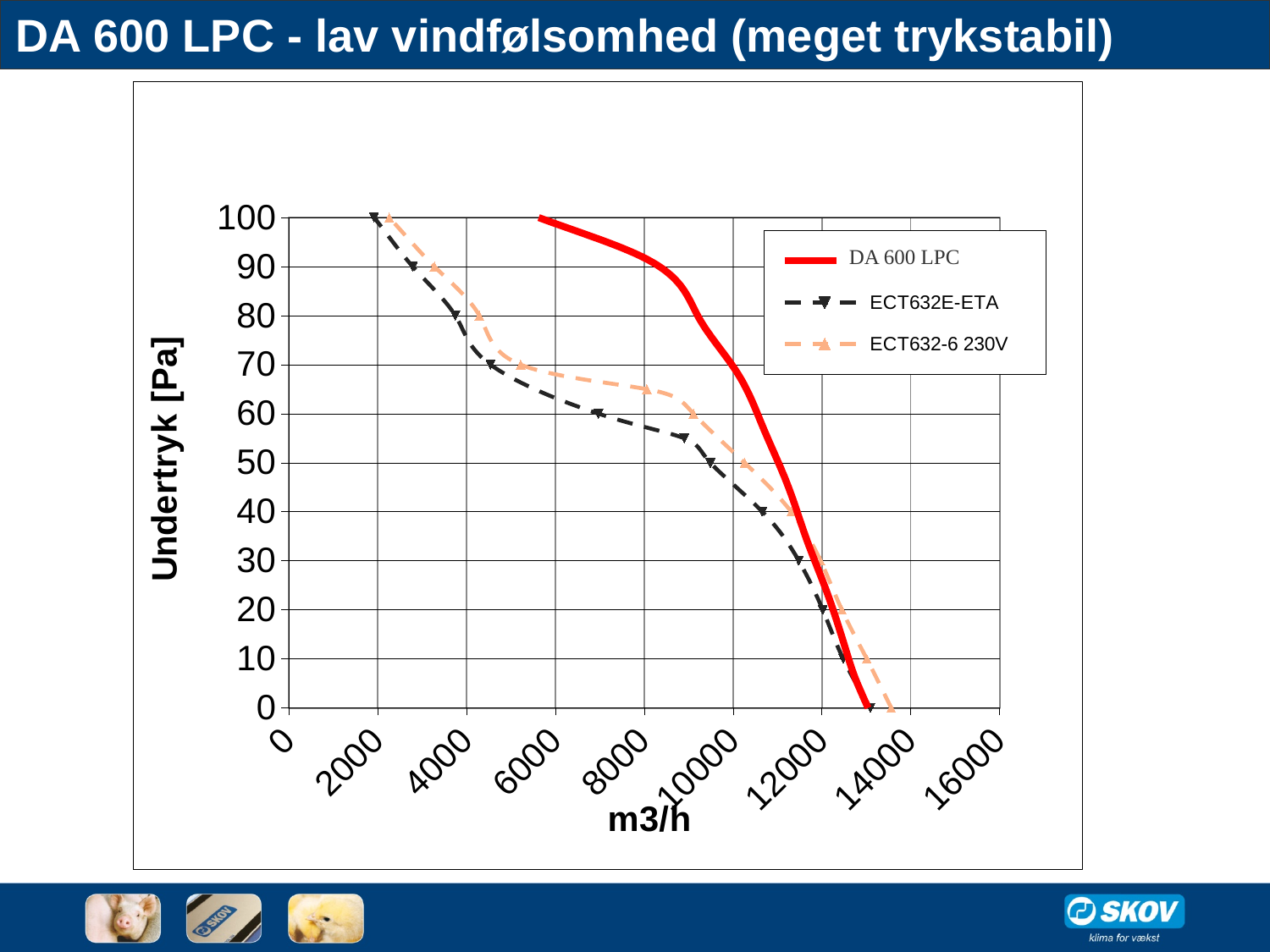
At 80 Pa, which series has the lower airflow: DA 600 LPC or ECT632-6 230V? ECT632-6 230V At 60 Pa, which series has the higher airflow: DA 600 LPC or ECT632E-ETA? DA 600 LPC At 100 Pa, is the airflow value for ECT632-6 230V greater or less than 4000 m3/h? less At 100 Pa, is the airflow value for DA 600 LPC greater or less than 4000 m3/h? greater What is the highest value shown on the x axis? 16000 What kind of chart is shown on the slide? line chart Which series is drawn as a solid red line? DA 600 LPC Which series reaches the highest airflow at 100 Pa? DA 600 LPC As airflow (m3/h) increases along the x axis, does the pressure (Undertryk) for DA 600 LPC rise or fall? fall What is the label of the y axis? Undertryk [Pa] At 0 Pa, is the airflow value for ECT632-6 230V greater or less than 12000 m3/h? greater How many series does the legend list? 3